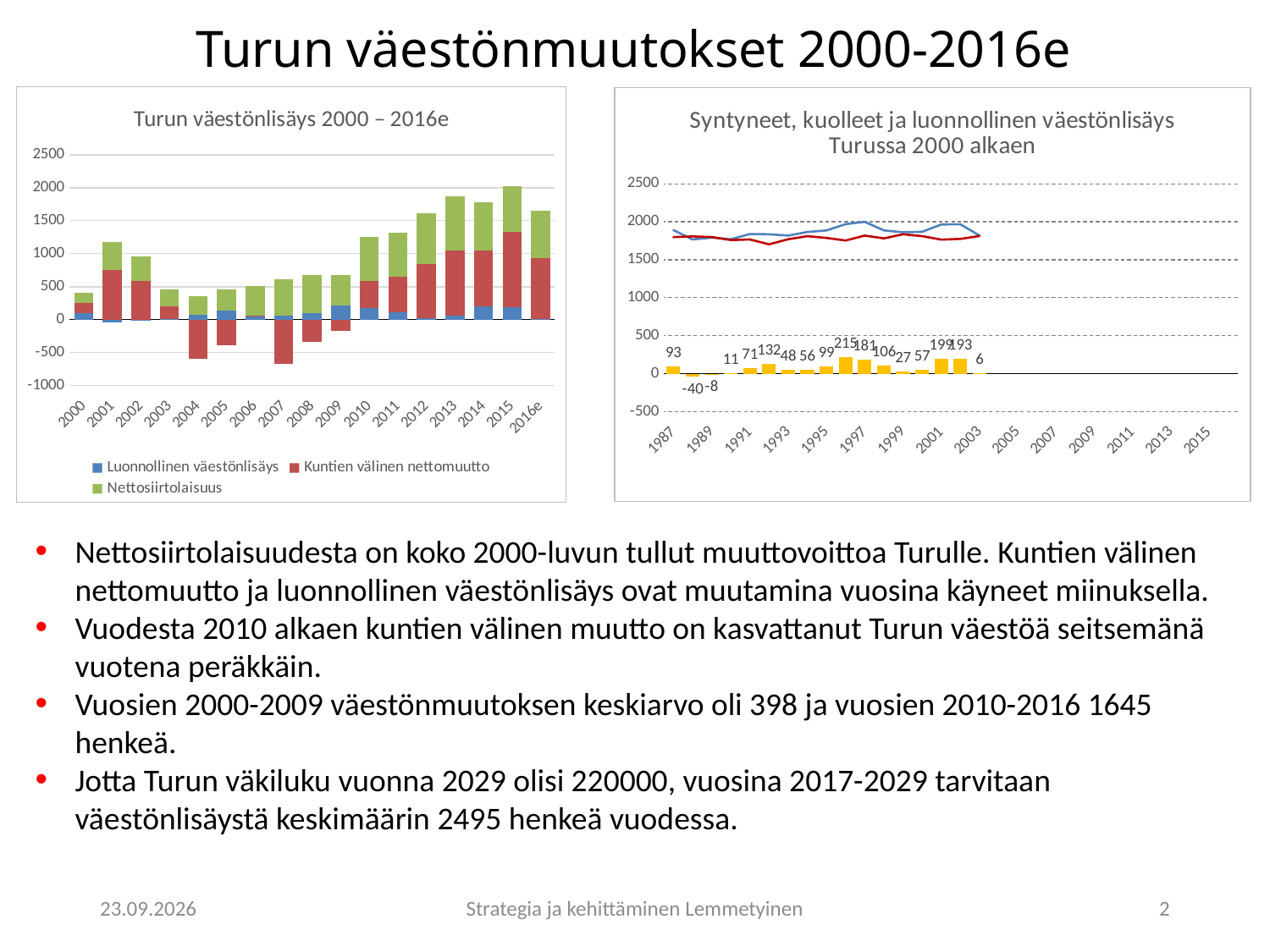
How many series does the legend of the left chart 'Turun väestönlisäys 2000 – 2016e' list? 3 In the right chart 'Syntyneet, kuolleet ja luonnollinen väestönlisäys Turussa 2000 alkaen', what is the lowest data label shown on the bars? -40 In the right chart 'Syntyneet, kuolleet ja luonnollinen väestönlisäys Turussa 2000 alkaen', how many bars have data labels? 17 In the left chart 'Turun väestönlisäys 2000 – 2016e', is the total stacked bar for 2012 larger or smaller than the one for 2003? 2012 is larger In the left chart 'Turun väestönlisäys 2000 – 2016e', which series is shown in green? Nettosiirtolaisuus What kind of chart is the left chart, 'Turun väestönlisäys 2000 – 2016e'? Stacked bar chart In the left chart 'Turun väestönlisäys 2000 – 2016e', is the total stacked value for 2013 greater or less than 1500? greater In the left chart 'Turun väestönlisäys 2000 – 2016e', is the Kuntien välinen nettomuutto value for 2007 greater or less than -500? less How many years (categories) are shown on the x axis of the left chart 'Turun väestönlisäys 2000 – 2016e'? 17 In the right chart 'Syntyneet, kuolleet ja luonnollinen väestönlisäys Turussa 2000 alkaen', what is the highest data label shown on the bars? 215 In the left chart 'Turun väestönlisäys 2000 – 2016e', which year has the tallest stacked bar? 2015